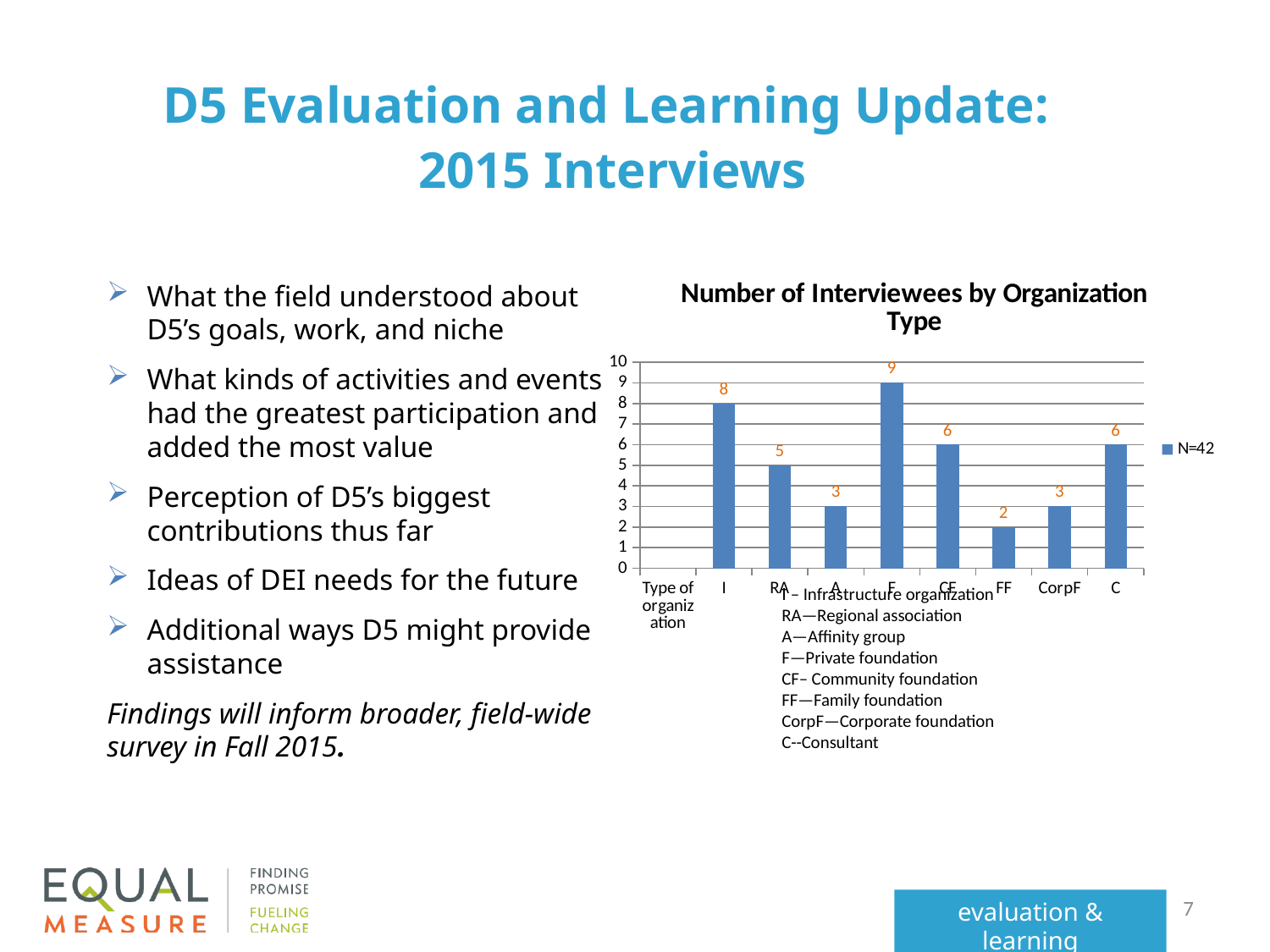
How many bars are plotted in the chart? 8 What is the number of interviewees for category F? 9 Which organization type has the lowest number of interviewees? FF Which has more interviewees, I or CF? I Which organization type has the highest number of interviewees? F What is the legend entry shown for the chart? N=42 What is the title of the chart on the slide? Number of Interviewees by Organization Type What is the difference between the number of interviewees for F and for RA? 4 What is the number of interviewees for category I in the 'Number of Interviewees by Organization Type' chart? 8 What is the number of interviewees for category CorpF? 3 What kind of chart is shown on the slide? Bar chart What is the number of interviewees for category FF? 2